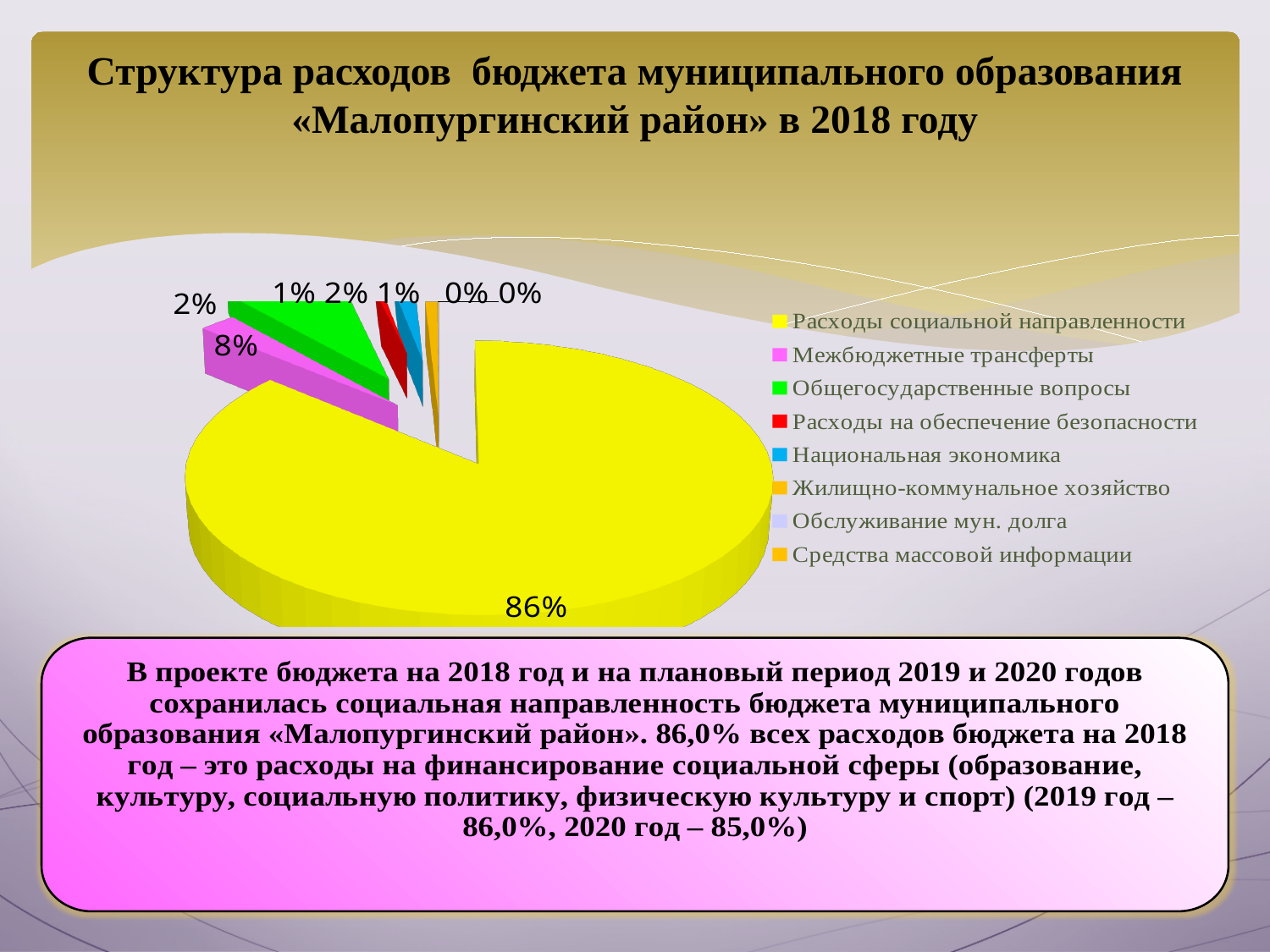
What share is labelled for «Общегосударственные вопросы»? 8% What share of the budget expenditures is labelled for «Межбюджетные трансферты»? 2% What share of the budget expenditures is labelled for «Расходы социальной направленности»? 86% What colour is the slice for «Расходы социальной направленности»? yellow How many categories does the legend list? 8 Which is larger: the slice for «Межбюджетные трансферты» or the slice for «Общегосударственные вопросы»? Общегосударственные вопросы What is the difference in percentage points between «Расходы социальной направленности» and «Межбюджетные трансферты»? 84 What kind of chart is shown on the slide? pie chart Which year does the chart title say the expenditure structure refers to? 2018 Which category has the largest slice of the pie? Расходы социальной направленности How many slices are labelled 0%? 2